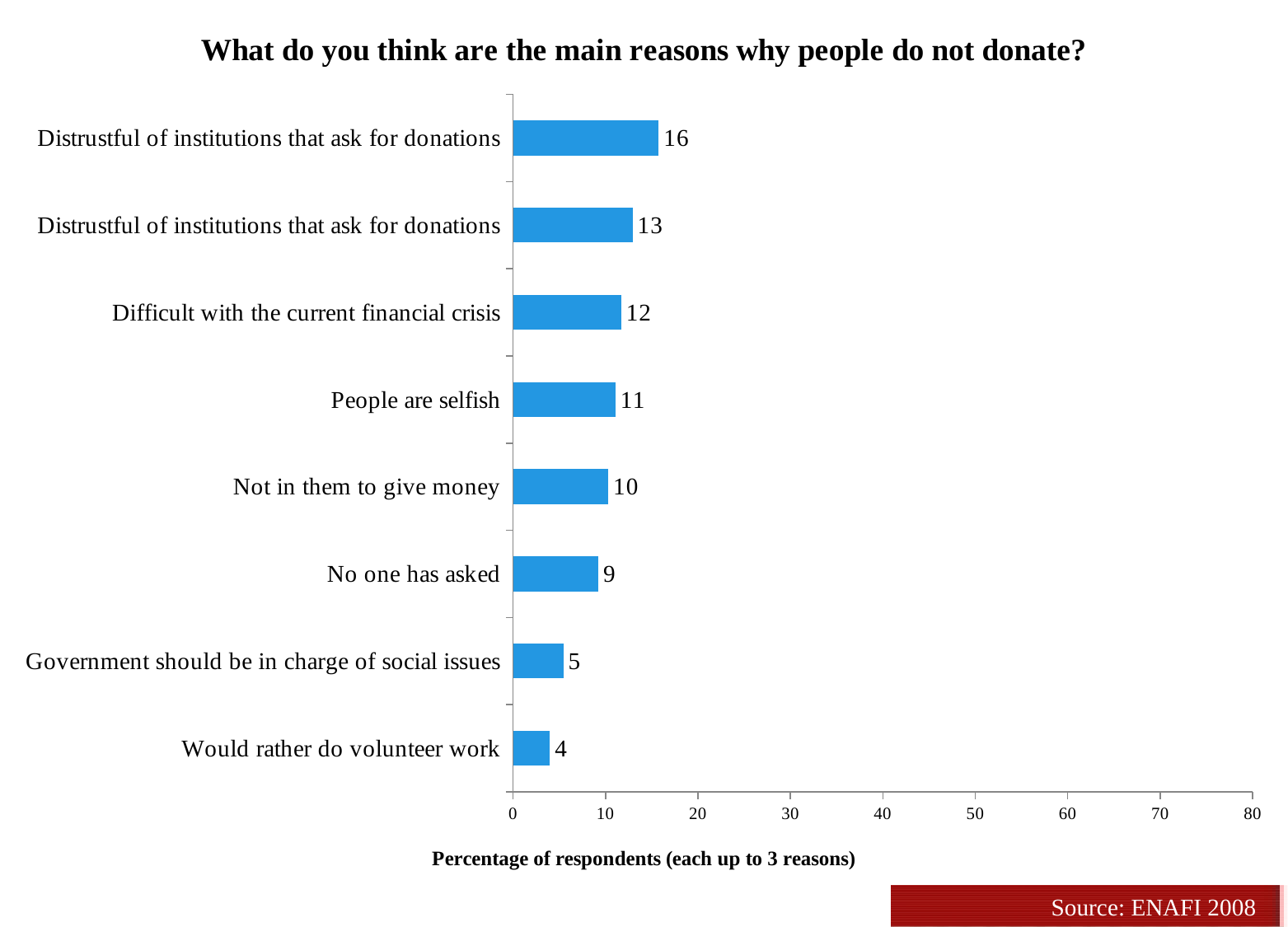
Which reason has the lowest percentage of respondents? Would rather do volunteer work How many reasons (bars) are shown on the chart? 8 What percentage of respondents gave "People are selfish" as a reason? 11 What is the value for "Government should be in charge of social issues"? 5 What is the label of the horizontal axis? Percentage of respondents (each up to 3 reasons) What is the difference between the values for "People are selfish" and "Would rather do volunteer work"? 7 What is the value for "Difficult with the current financial crisis"? 12 What is the highest value shown on the chart? 16 Which is larger, the value for "No one has asked" or the value for "Government should be in charge of social issues"? No one has asked What is the value for "Would rather do volunteer work"? 4 What kind of chart is shown on the slide? Bar chart What is the difference between the values for "Not in them to give money" and "No one has asked"? 1